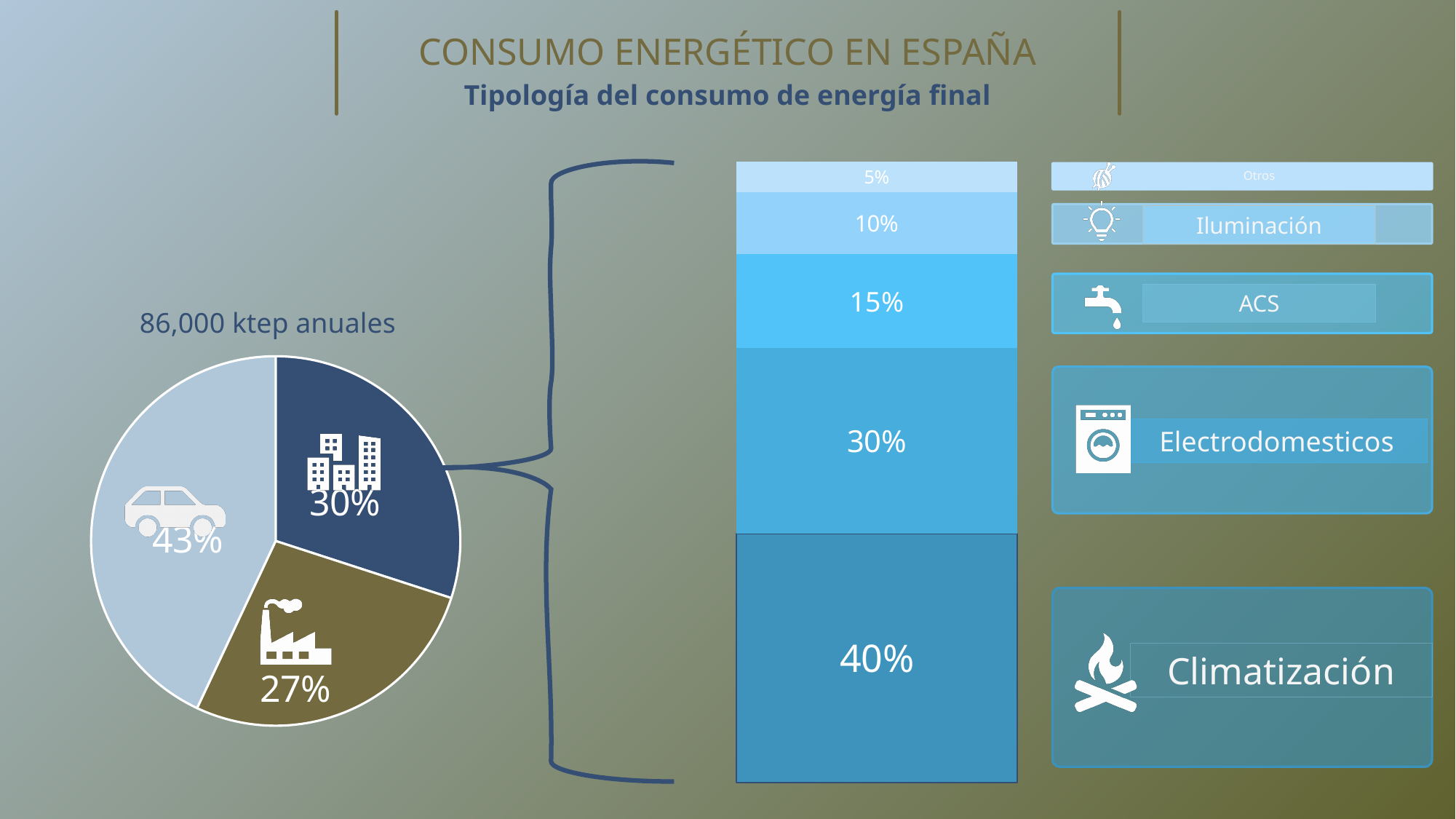
On the stacked bar in the centre, which segment is the smallest? Otros (5%) On the stacked bar in the centre, what percentage corresponds to ACS? 15% On the pie chart on the left, which slice has the smallest share? The slice with the factory icon (27%) On the stacked bar in the centre, what percentage corresponds to Climatización? 40% On the pie chart on the left, which slice has the largest share? The slice with the car icon (43%) On the stacked bar in the centre, what is the difference between Electrodomesticos and Iluminación? 20% What annual total is stated above the pie chart on the left? 86,000 ktep anuales On the pie chart on the left, what percentage is shown on the slice with the buildings icon? 30% How many slices does the pie chart on the left have? 3 On the pie chart on the left, what percentage is shown on the slice with the factory icon? 27% On the pie chart on the left, what percentage is shown on the slice with the car icon? 43% On the pie chart on the left, what is the difference between the car slice and the factory slice? 16%